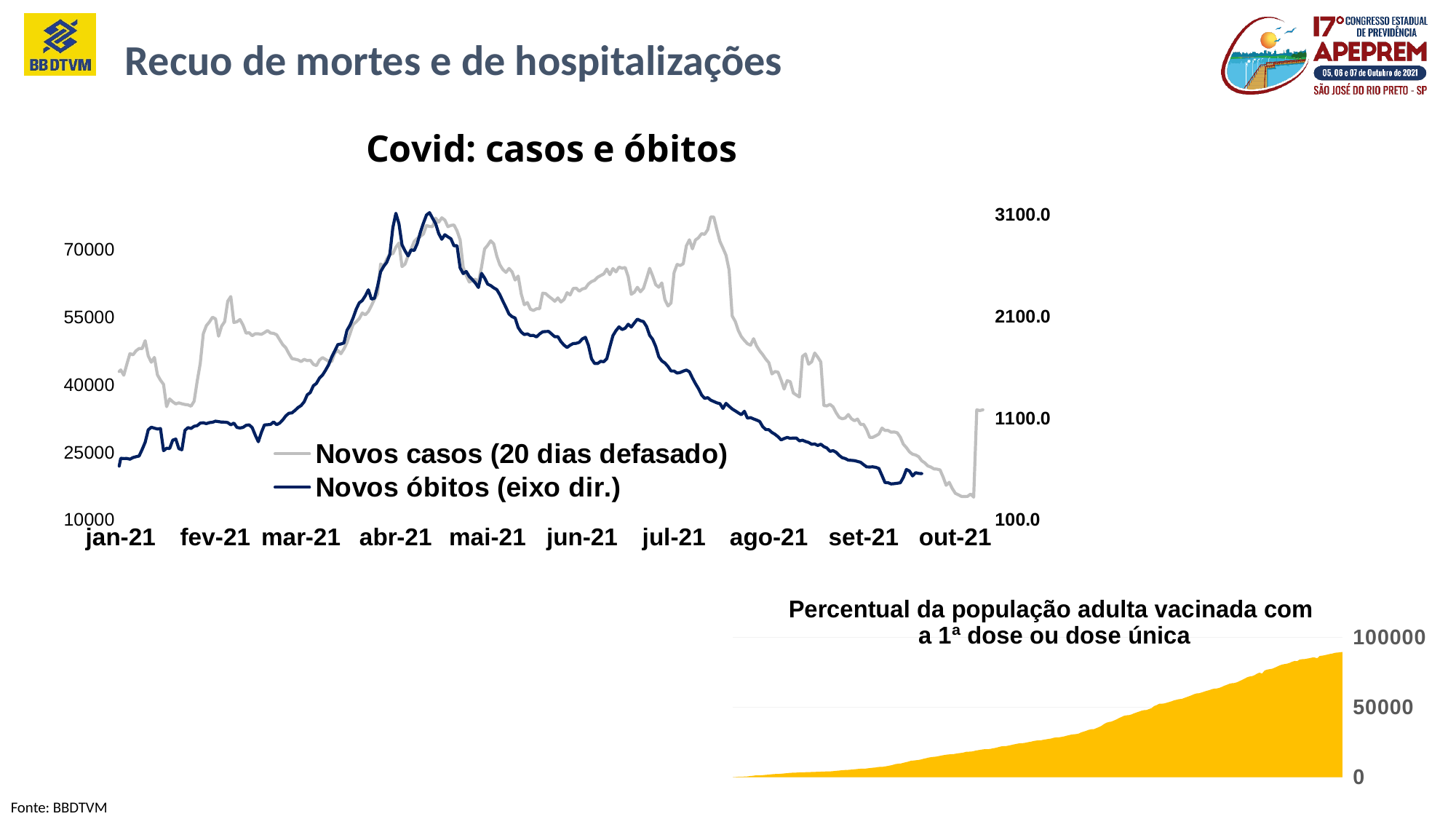
In the 'Covid: casos e óbitos' chart, do the values of 'Novos óbitos (eixo dir.)' rise or fall between jun-21 and set-21? fall In the 'Percentual da população adulta vacinada com a 1ª dose ou dose única' chart, do the values rise or fall along the x axis? rise In the 'Covid: casos e óbitos' chart, is the value of 'Novos casos (20 dias defasado)' at jan-21 greater or less than 55000? less What kind of chart is the 'Percentual da população adulta vacinada com a 1ª dose ou dose única' chart? area chart In the 'Covid: casos e óbitos' chart, is the peak value of 'Novos óbitos (eixo dir.)' around abr-21 greater or less than 2100.0? greater How many series does the legend of the 'Covid: casos e óbitos' chart list? 2 How many month labels are shown on the x axis of the 'Covid: casos e óbitos' chart? 10 What kind of chart is the 'Covid: casos e óbitos' chart? line chart In the 'Percentual da população adulta vacinada com a 1ª dose ou dose única' chart, is the final value greater or less than 50000? greater In the 'Covid: casos e óbitos' chart, what is the highest value shown on the right axis? 3100.0 In the 'Covid: casos e óbitos' chart, which series is plotted on the right axis? Novos óbitos (eixo dir.)